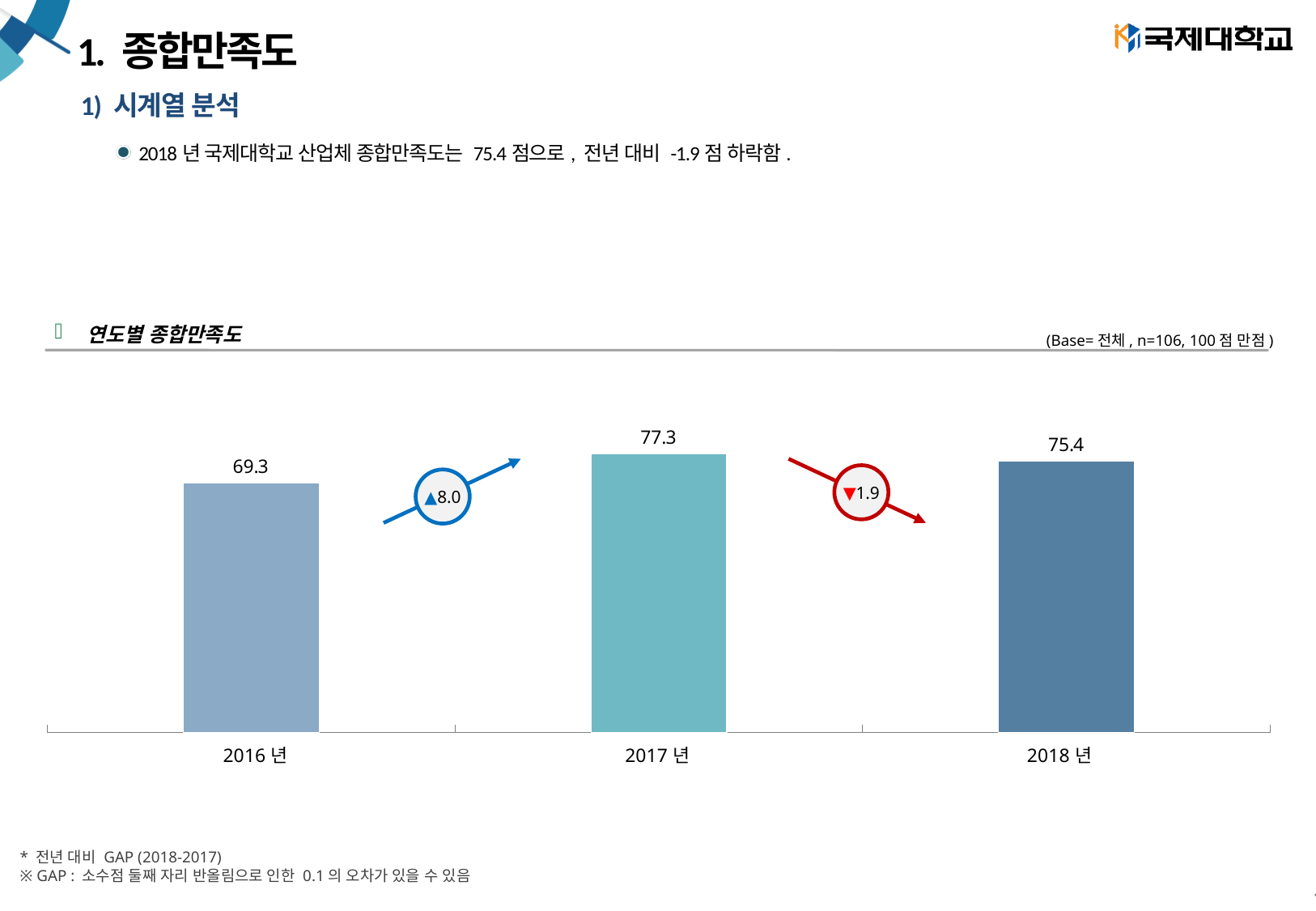
How many years are shown in the chart? 3 Does the value rise or fall from 2017년 to 2018년? fall Which year has the highest value? 2017년 What kind of chart is shown? bar chart What is the value for 2016년? 69.3 What is the difference between the values for 2017년 and 2018년? 1.9 What is the title of the chart? 연도별 종합만족도 What is the difference between the values for 2017년 and 2016년? 8.0 Which is larger, the value for 2016년 or the value for 2018년? 2018년 What is the value for 2018년? 75.4 Which year has the lowest value? 2016년 What is the value for 2017년? 77.3